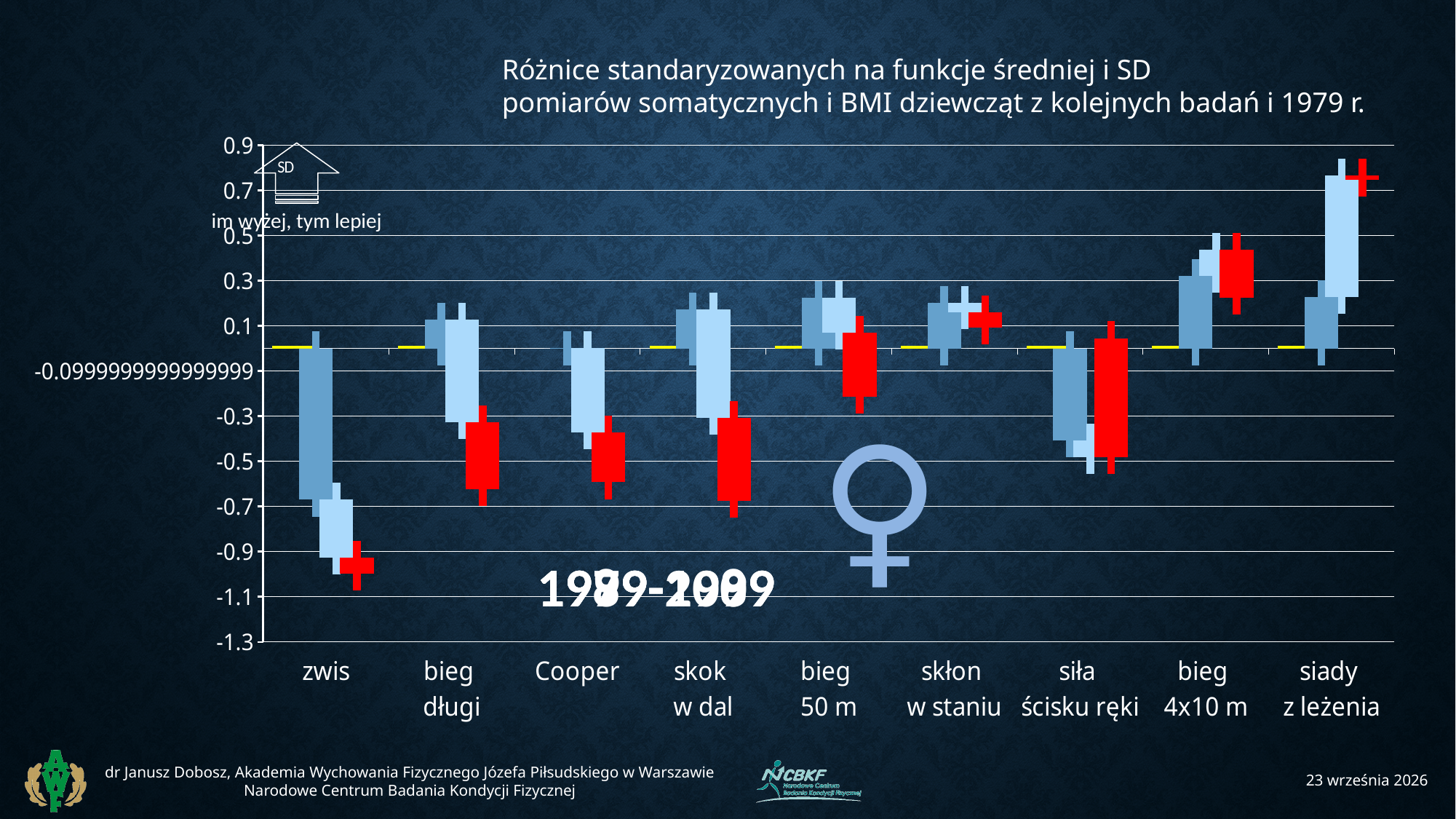
Is the red bar for bieg długi greater or less than -0.3? less Which category has the highest red bar on the chart? siady z leżenia Which category has the lowest red bar on the chart? zwis Is the red bar for zwis greater or less than -0.9? less How many test categories are shown on the x axis of the chart? 9 Which has the higher red bar: Cooper or bieg 4x10 m? bieg 4x10 m What is the lowest value shown on the vertical axis of the chart? -1.3 What is the title of the chart? Różnice standaryzowanych na funkcje średniej i SD pomiarów somatycznych i BMI dziewcząt z kolejnych badań i 1979 r. Is the red bar for siady z leżenia greater or less than 0.7? greater Which has the higher red bar: zwis or siady z leżenia? siady z leżenia